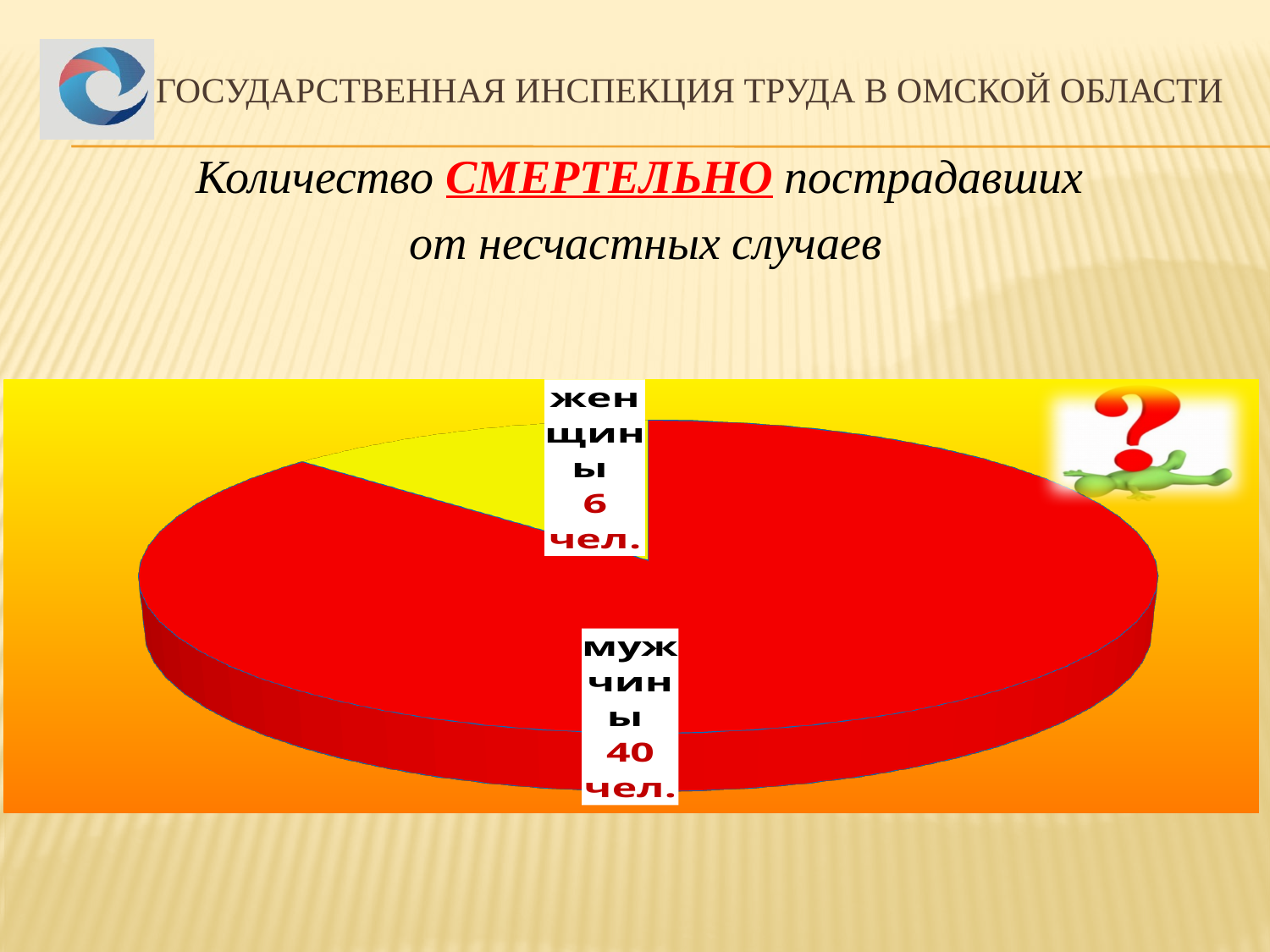
What is the title of the chart on the slide? Количество СМЕРТЕЛЬНО пострадавших от несчастных случаев How many slices does the pie chart have? 2 What is the total number of people represented in the pie chart? 46 What colour is the "женщины" slice of the pie chart? yellow Which slice of the pie chart is the smallest? женщины Which is larger in the pie chart, the value for мужчины or the value for женщины? мужчины Which slice of the pie chart is the largest? мужчины What is the difference between the number of men and the number of women in the pie chart? 34 How many people are shown for the "мужчины" slice of the pie chart? 40 чел. How many people are shown for the "женщины" slice of the pie chart? 6 чел. What kind of chart is shown on the slide? pie chart